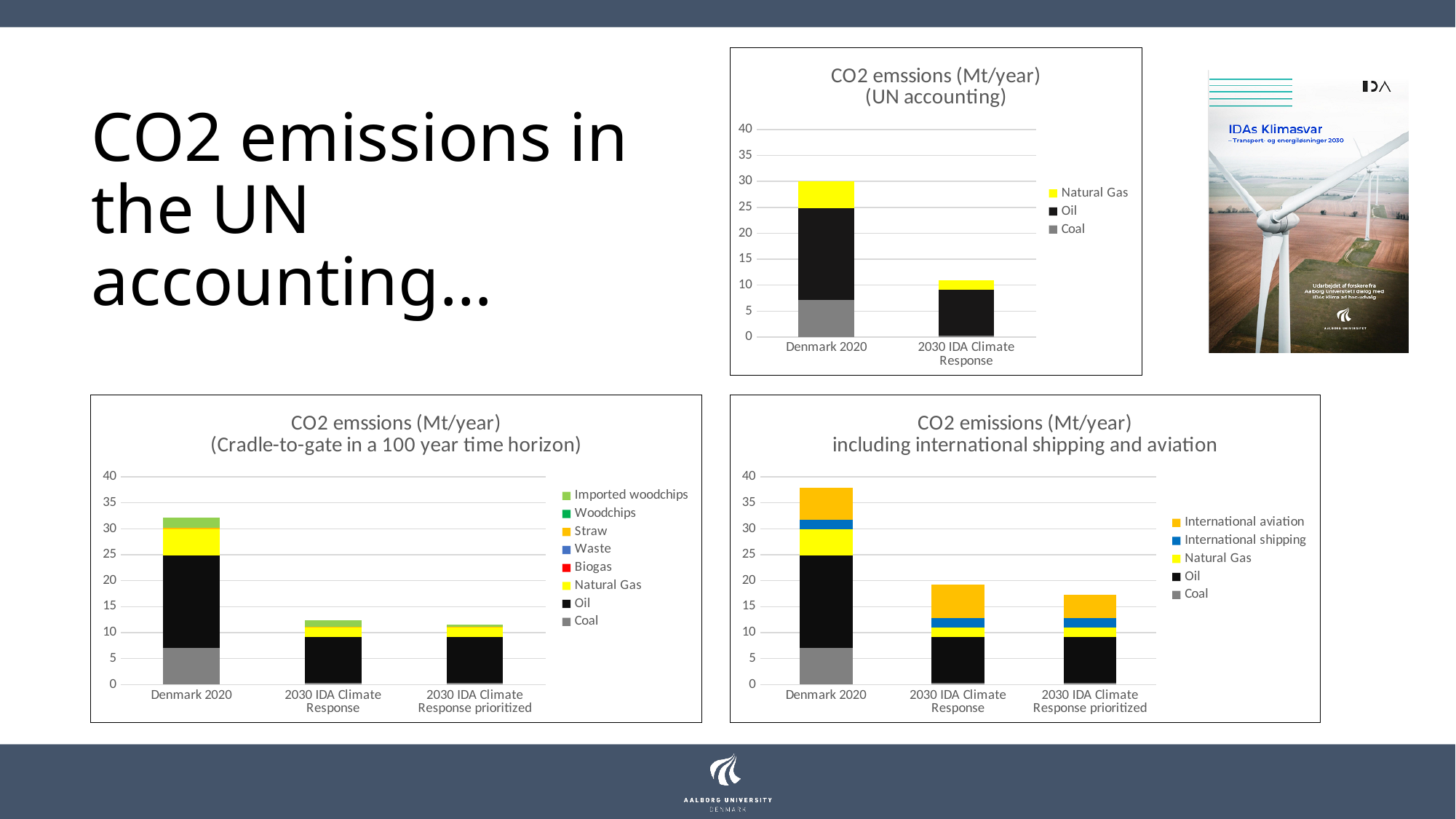
In the chart titled 'CO2 emssions (Mt/year) (Cradle-to-gate in a 100 year time horizon)', how many series does the legend list? 8 In the chart titled 'CO2 emssions (Mt/year) (UN accounting)', which category has the highest total emissions? Denmark 2020 In the chart titled 'CO2 emssions (Mt/year) (UN accounting)', how many series does the legend list? 3 In the chart titled 'CO2 emissions (Mt/year) including international shipping and aviation', which is larger, the total for Denmark 2020 or the total for 2030 IDA Climate Response? Denmark 2020 In the chart titled 'CO2 emissions (Mt/year) including international shipping and aviation', is the total for Denmark 2020 greater or less than 35? greater In the chart titled 'CO2 emssions (Mt/year) (Cradle-to-gate in a 100 year time horizon)', is the total for Denmark 2020 greater or less than 30? greater In the chart titled 'CO2 emssions (Mt/year) (UN accounting)', how many categories are shown on the x axis? 2 In the chart titled 'CO2 emissions (Mt/year) including international shipping and aviation', how many series does the legend list? 5 What type of chart is the chart titled 'CO2 emissions (Mt/year) including international shipping and aviation'? Stacked bar chart In the chart titled 'CO2 emssions (Mt/year) (Cradle-to-gate in a 100 year time horizon)', how many categories are shown on the x axis? 3 In the chart titled 'CO2 emssions (Mt/year) (UN accounting)', is the total for Denmark 2020 greater or less than 25? greater In the chart titled 'CO2 emssions (Mt/year) (Cradle-to-gate in a 100 year time horizon)', which category has the lowest total emissions? 2030 IDA Climate Response prioritized